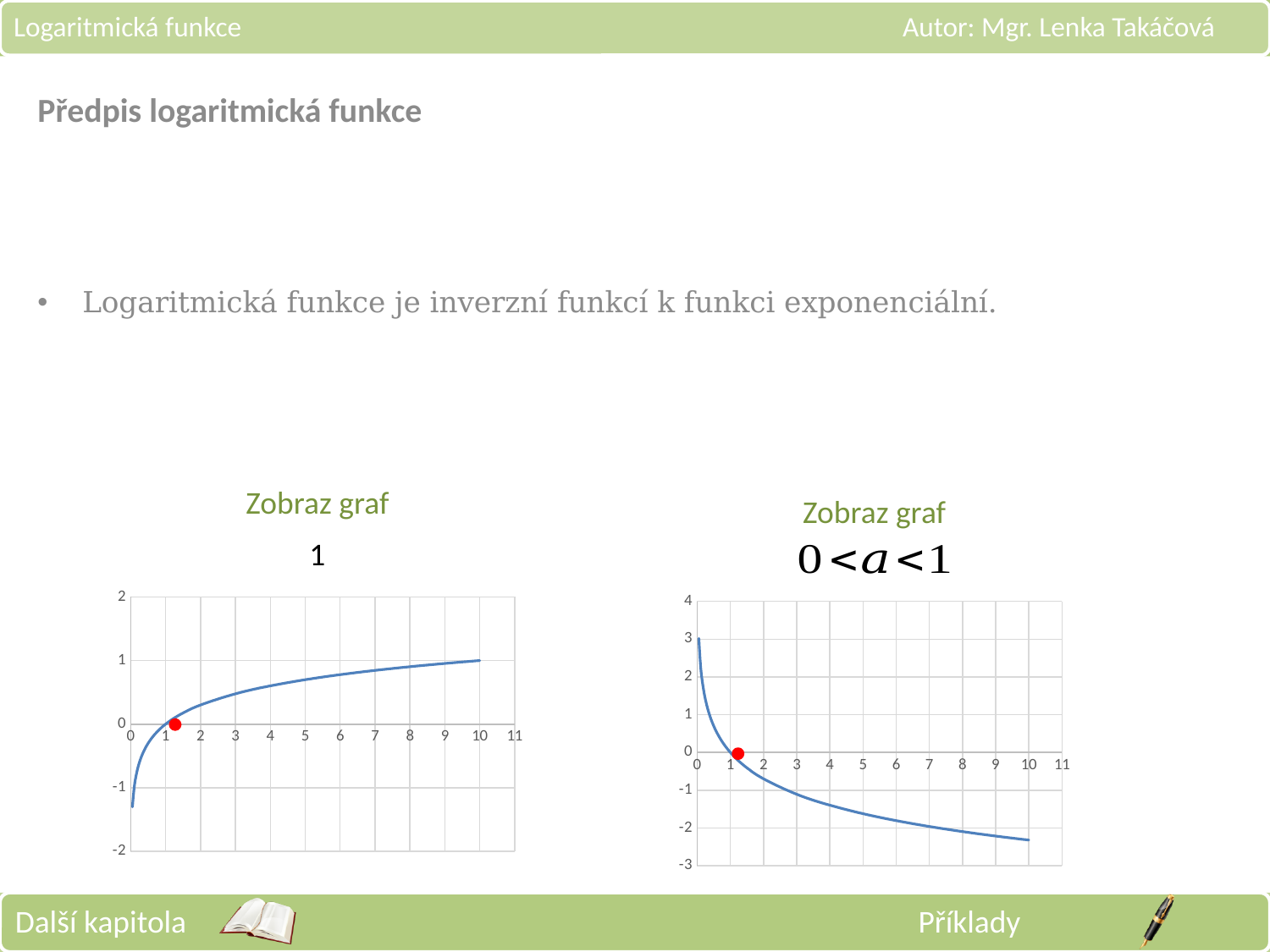
What is the lowest value shown on the y axis of the left chart titled "1"? -2 In the right chart titled "0 < a < 1", is the value at x = 5 greater or less than 0? less In the right chart titled "0 < a < 1", do the values rise or fall as x increases? fall What kind of chart is the right chart titled "0 < a < 1"? line chart In the right chart titled "0 < a < 1", is the value at x = 10 greater or less than -1? less In the left chart titled "1", is the value at x = 10 greater or less than 0? greater In the left chart titled "1", do the values rise or fall as x increases? rise What kind of chart is the left chart titled "1"? line chart What is the highest value shown on the y axis of the right chart titled "0 < a < 1"? 4 How many charts are shown on the slide? 2